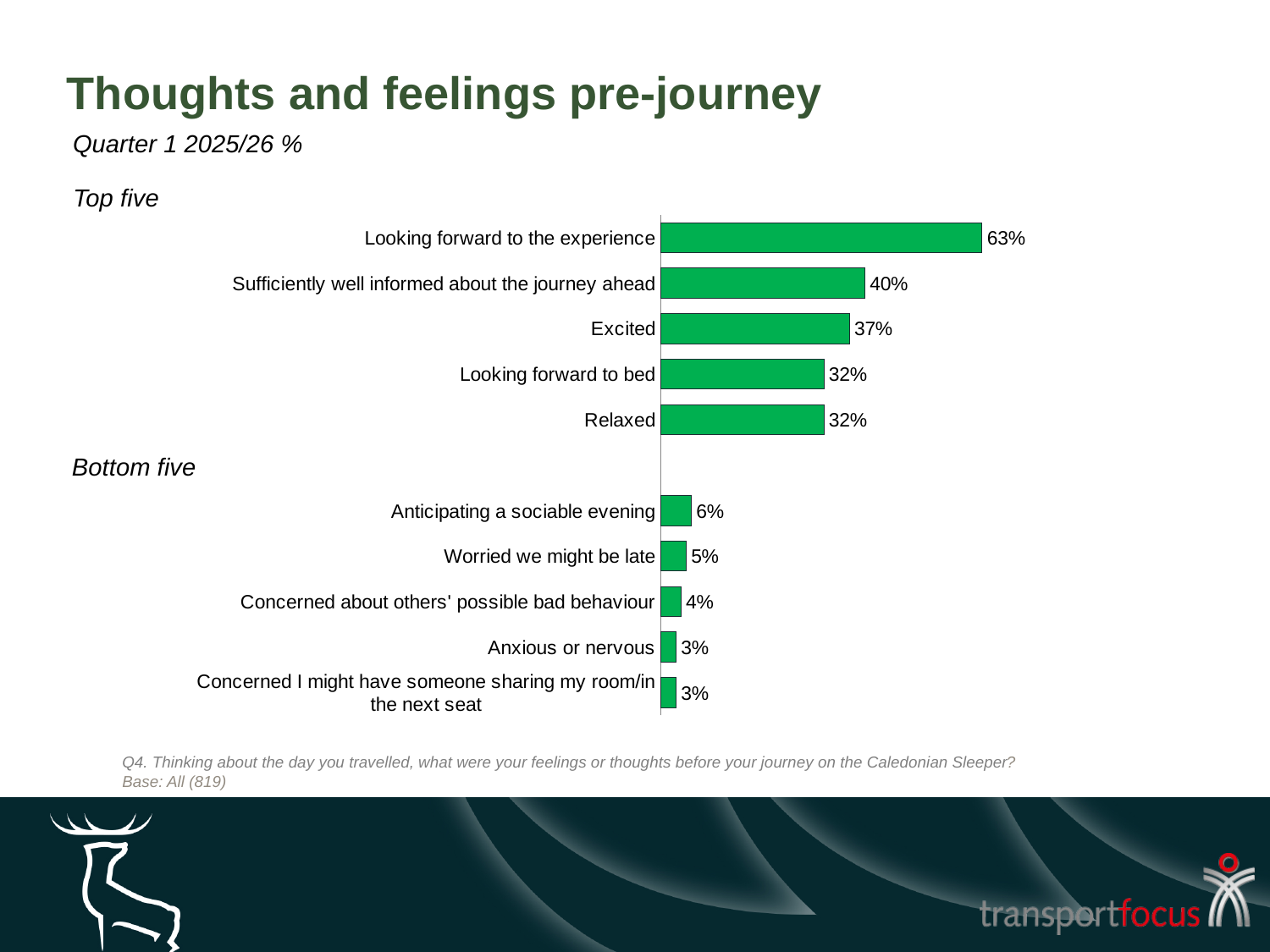
Which is larger: 'Anticipating a sociable evening' or 'Concerned about others' possible bad behaviour'? Anticipating a sociable evening What is the base size stated on the slide? All (819) How many categories are plotted on the chart in total? 10 Which category has the highest value on the chart? Looking forward to the experience What is the value for 'Worried we might be late'? 5% What type of chart is shown on the slide? Bar chart What is the difference between 'Looking forward to the experience' and 'Sufficiently well informed about the journey ahead'? 23 percentage points Which category in the top five has the lowest value? Looking forward to bed and Relaxed (both 32%) What is the value for 'Concerned I might have someone sharing my room/in the next seat'? 3% What percentage of respondents were looking forward to the experience? 63% What is the value for 'Excited'? 37% What is the difference between 'Anticipating a sociable evening' and 'Anxious or nervous'? 3 percentage points